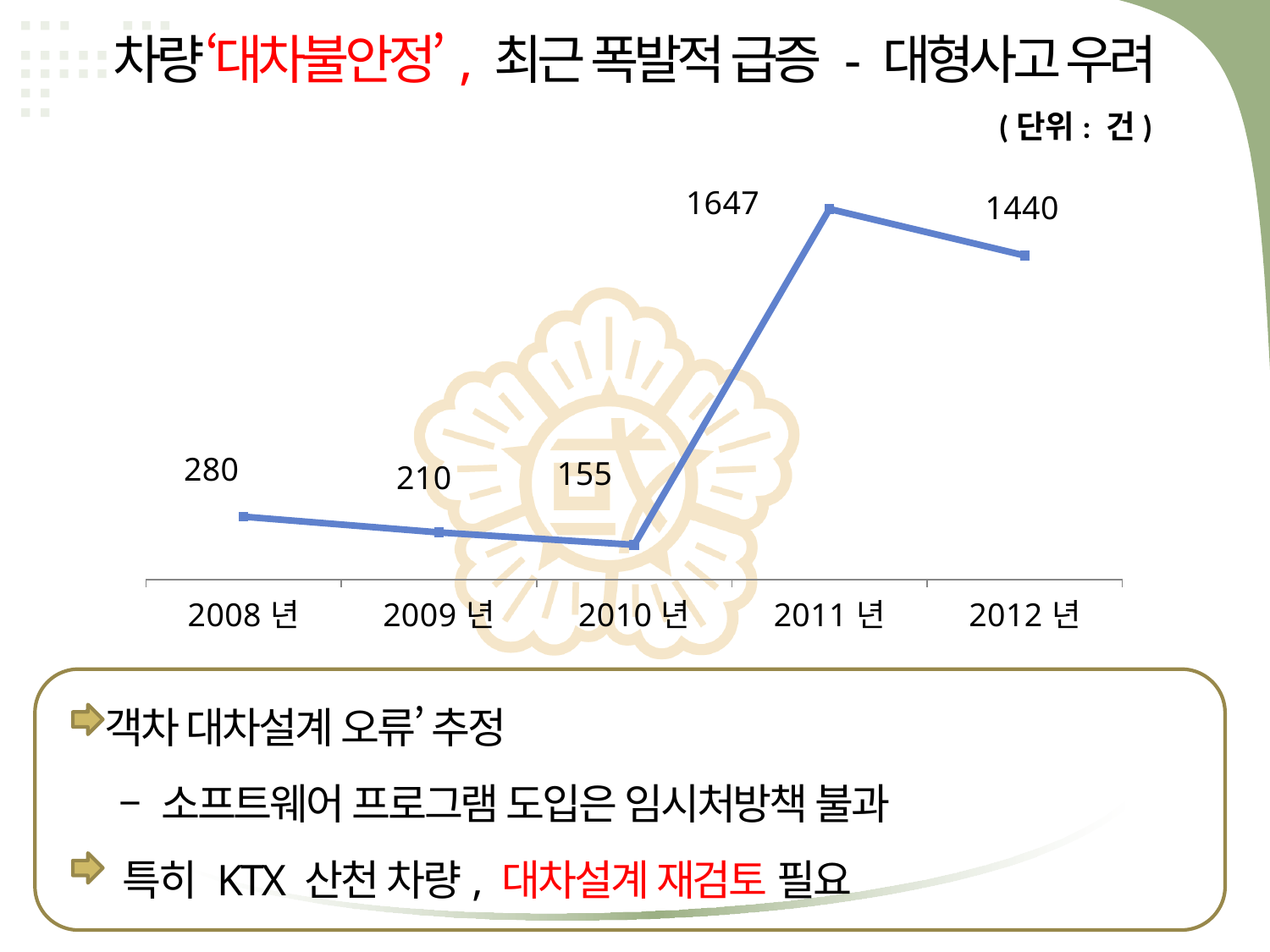
Which is larger, the value for 2009 년 or the value for 2010 년? 2009 년 How many years are plotted on the chart? 5 What is the difference between the values for 2008 년 and 2009 년? 70 Does the value rise or fall from 2010 년 to 2011 년? rise What kind of chart is shown on the slide? line chart What is the difference between the values for 2011 년 and 2012 년? 207 What is the value for 2011 년? 1647 What is the value for 2008 년? 280 What is the value for 2010 년? 155 Which year has the lowest value? 2010 년 What is the value for 2012 년? 1440 Which year has the highest value? 2011 년